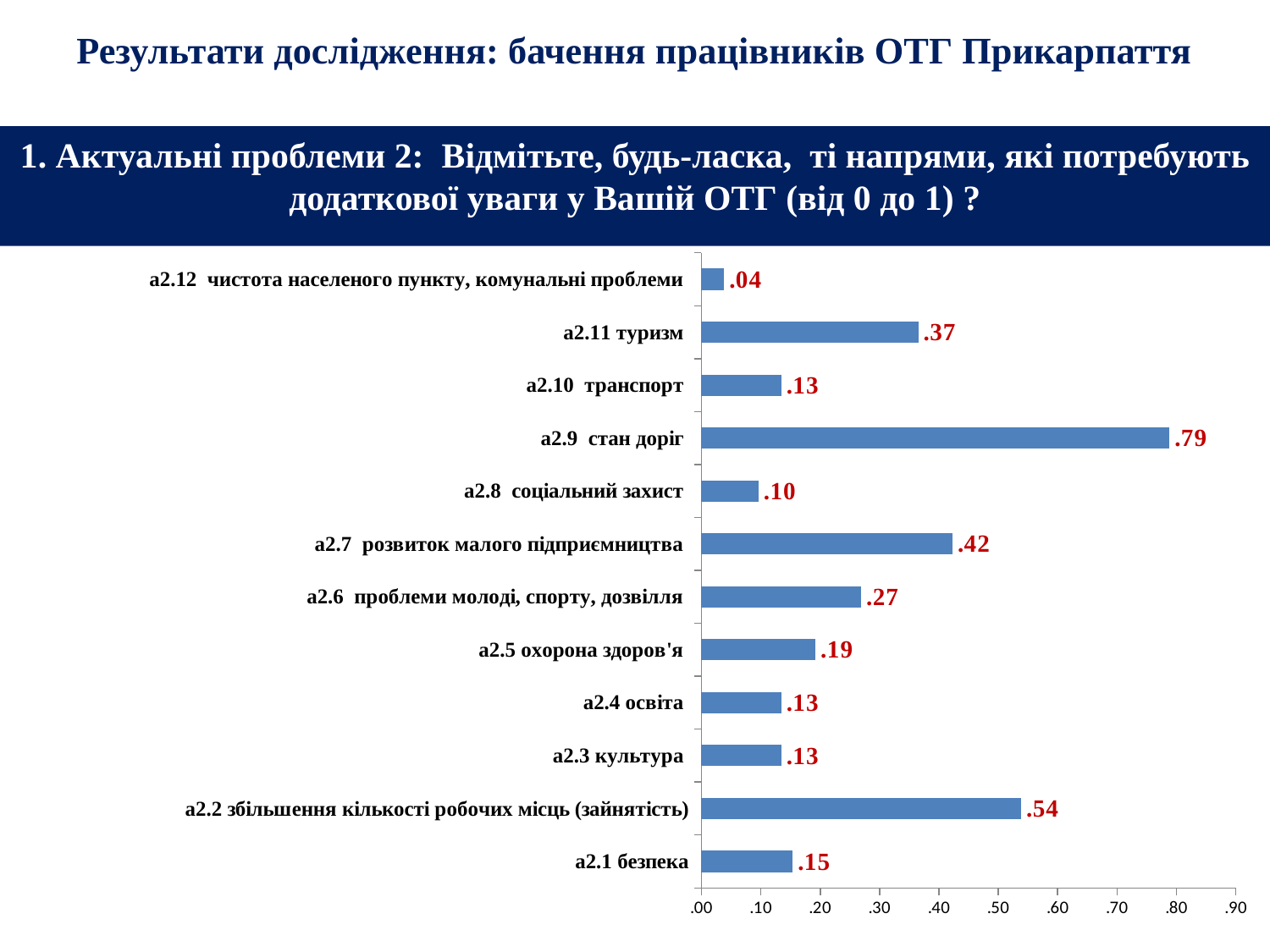
What is the value for a2.9 стан доріг? .79 Which category has the lowest value? a2.12 чистота населеного пункту, комунальні проблеми What is the value for a2.11 туризм? .37 What is the value for a2.8 соціальний захист? .10 What is the value for a2.2 збільшення кількості робочих місць (зайнятість)? .54 What is the highest value shown on the horizontal axis? .90 Is the value for a2.5 охорона здоров'я greater or less than .30? less Which is larger, the value for a2.7 розвиток малого підприємництва or a2.6 проблеми молоді, спорту, дозвілля? a2.7 розвиток малого підприємництва What is the difference between the values for a2.9 стан доріг and a2.2 збільшення кількості робочих місць (зайнятість)? .25 Which category has the highest value? a2.9 стан доріг What kind of chart is shown on the slide? bar chart How many categories are shown in the chart? 12